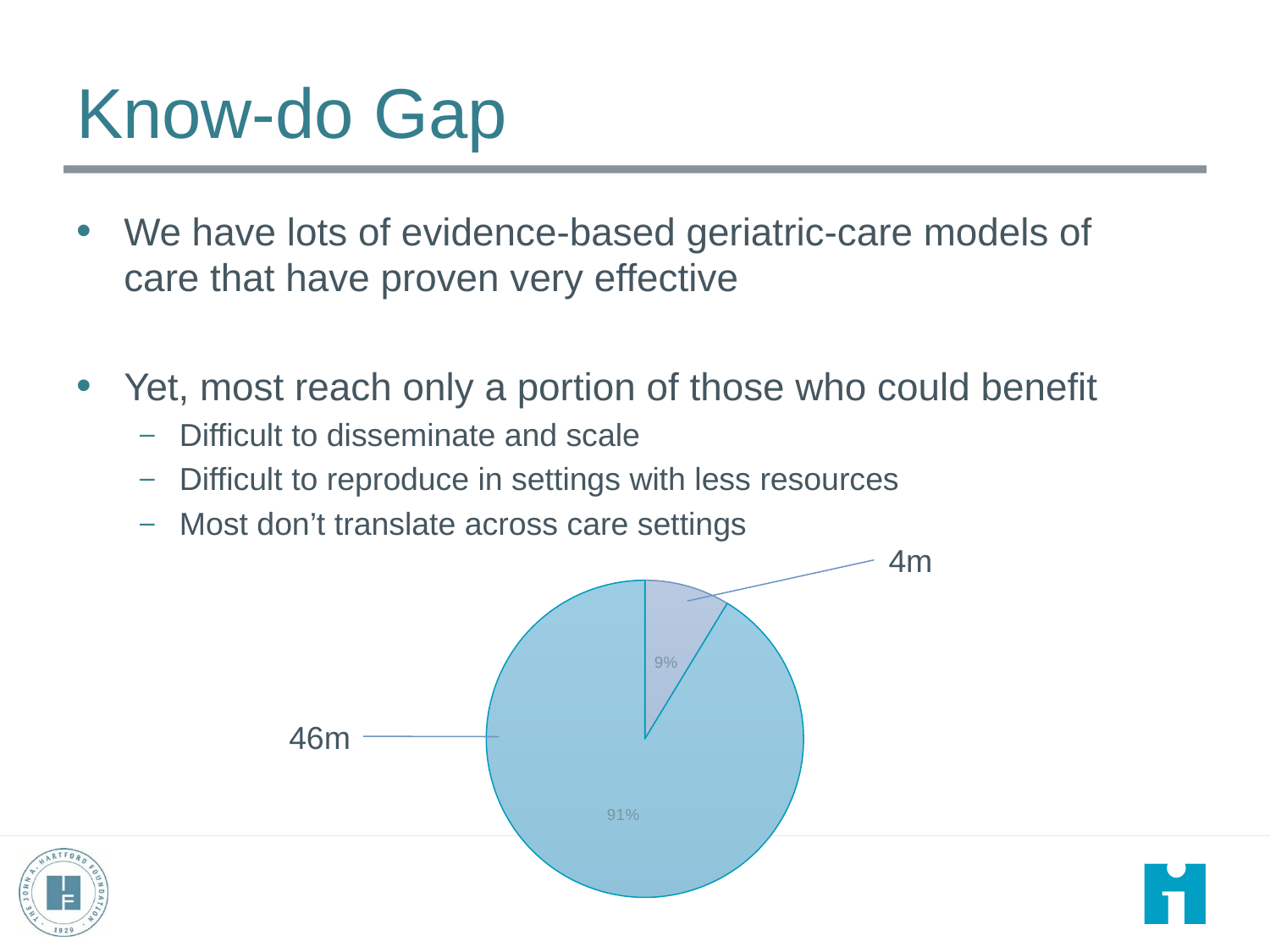
Which is larger in the pie chart, the 46m slice or the 4m slice? 46m What is the difference between the two values shown in the pie chart, 46m and 4m? 42m Does the pie chart have a legend? No Which slice of the pie chart is the smallest? 4m What is the combined total of the two values labelled on the pie chart? 50m What share of the pie does the 4m slice represent? 9% What is the percentage label printed inside the larger slice of the pie chart? 91% What kind of chart is shown on the slide? pie chart What share of the pie does the 46m slice represent? 91% How many slices does the pie chart have? 2 What is the percentage label printed inside the smaller slice of the pie chart? 9% Which slice of the pie chart is the largest? 46m